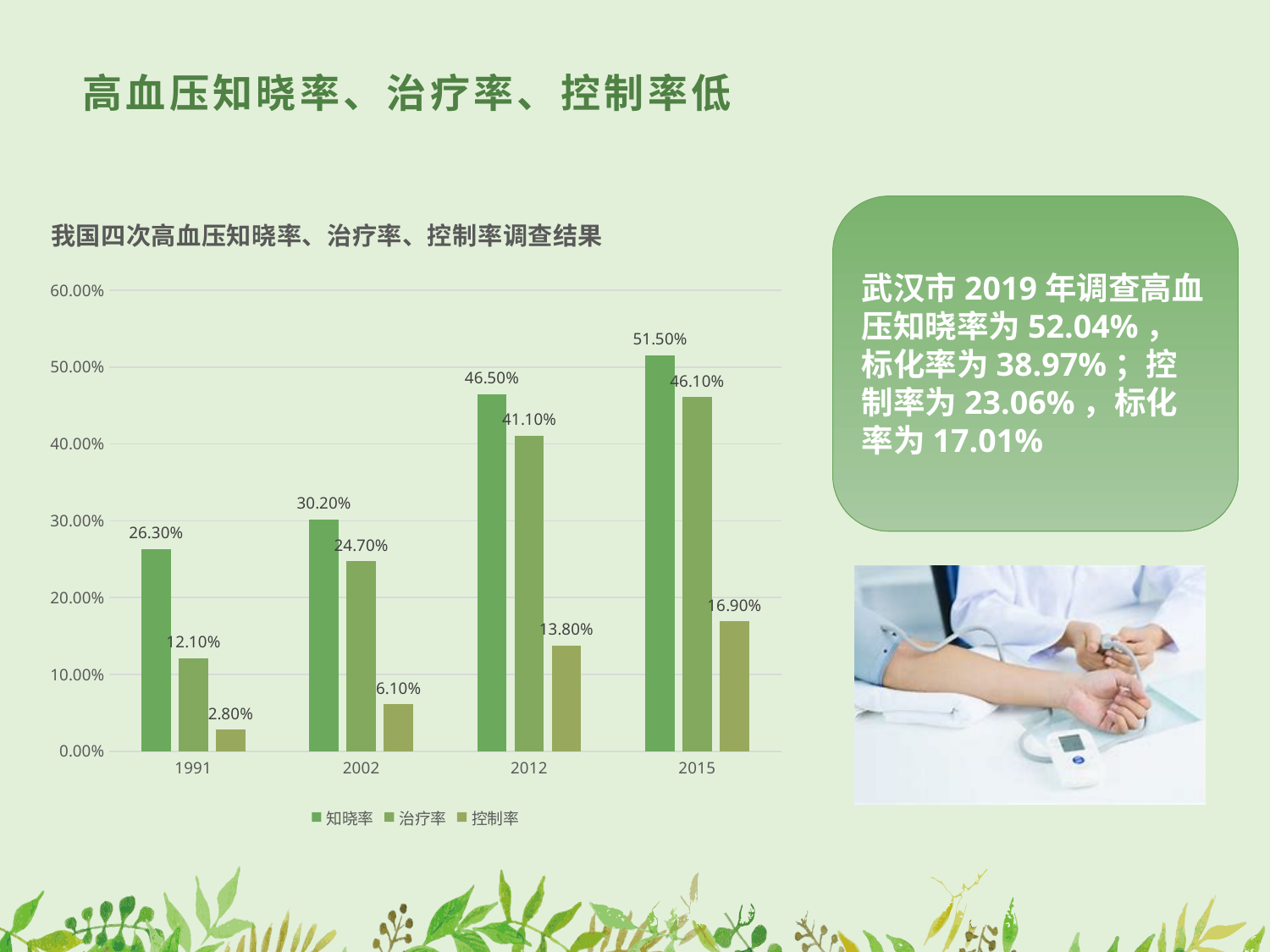
What kind of chart is shown on the slide? Bar chart Which year has the highest 知晓率? 2015 Does the 控制率 rise or fall from 1991 to 2015? Rise How many years are shown on the x axis? 4 What is the 治疗率 value for 2002? 24.70% How many series does the legend list? 3 What is the 控制率 value for 1991? 2.80% What is the difference between the 知晓率 and 治疗率 values in 2012? 5.40% Which is larger, the 治疗率 in 2015 or the 知晓率 in 2012? 知晓率 in 2012 Which year has the lowest 控制率? 1991 What is the title of the chart? 我国四次高血压知晓率、治疗率、控制率调查结果 What is the 知晓率 value for 2015? 51.50%